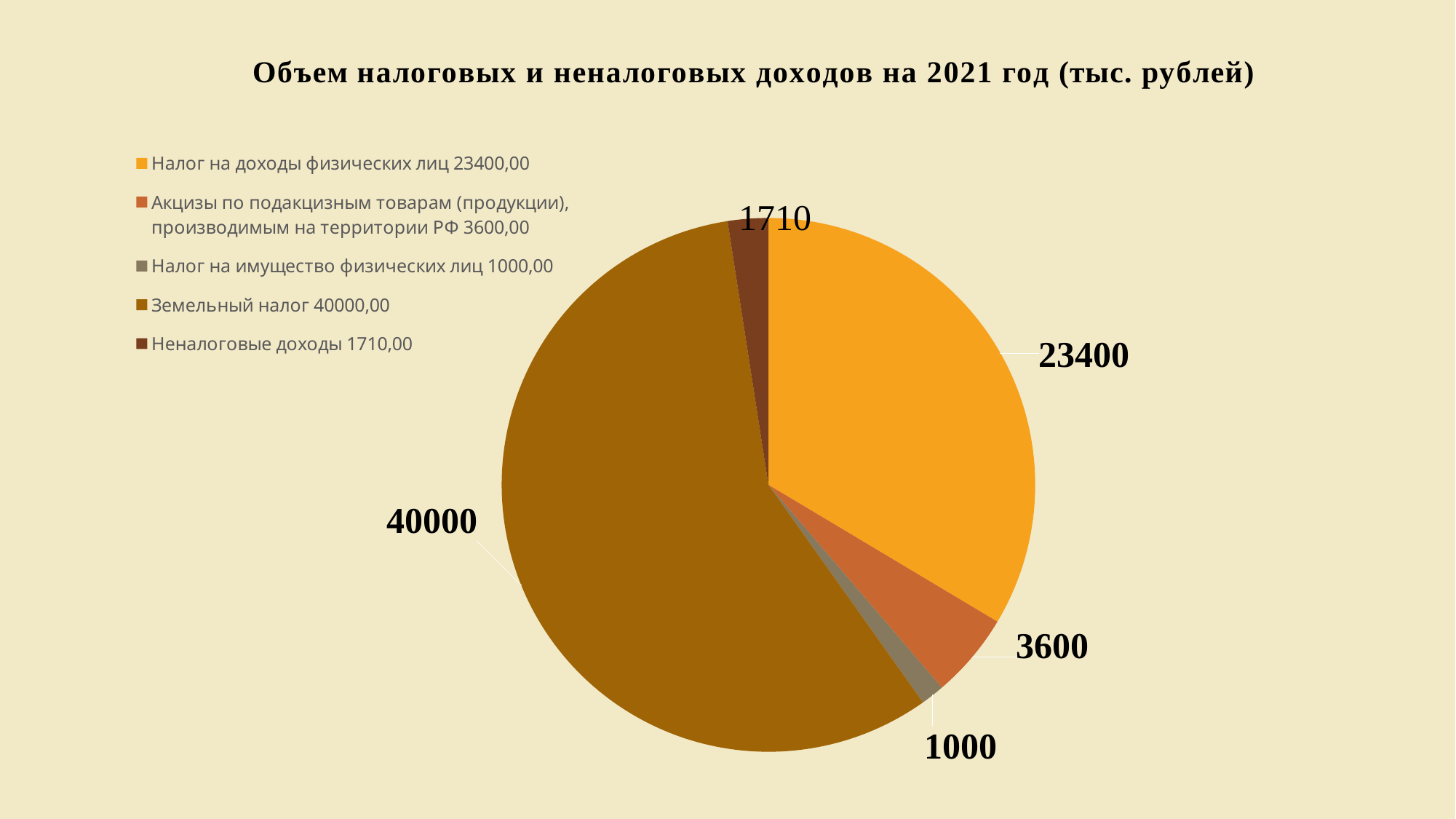
Which category has the largest slice of the pie? Земельный налог What is the value for Налог на имущество физических лиц? 1000 What is the title of the chart? Объем налоговых и неналоговых доходов на 2021 год (тыс. рублей) What is the value for Земельный налог? 40000 Which category has the smallest slice of the pie? Налог на имущество физических лиц What is the value for Налог на доходы физических лиц? 23400 What is the difference between the values for Земельный налог and Налог на доходы физических лиц? 16600 How many slices does the pie chart have? 5 What type of chart is shown on the slide? pie chart Which is larger: the value for Акцизы по подакцизным товарам or the value for Неналоговые доходы? Акцизы по подакцизным товарам What is the total of all the values shown in the pie chart? 69710 What is the value for Неналоговые доходы? 1710